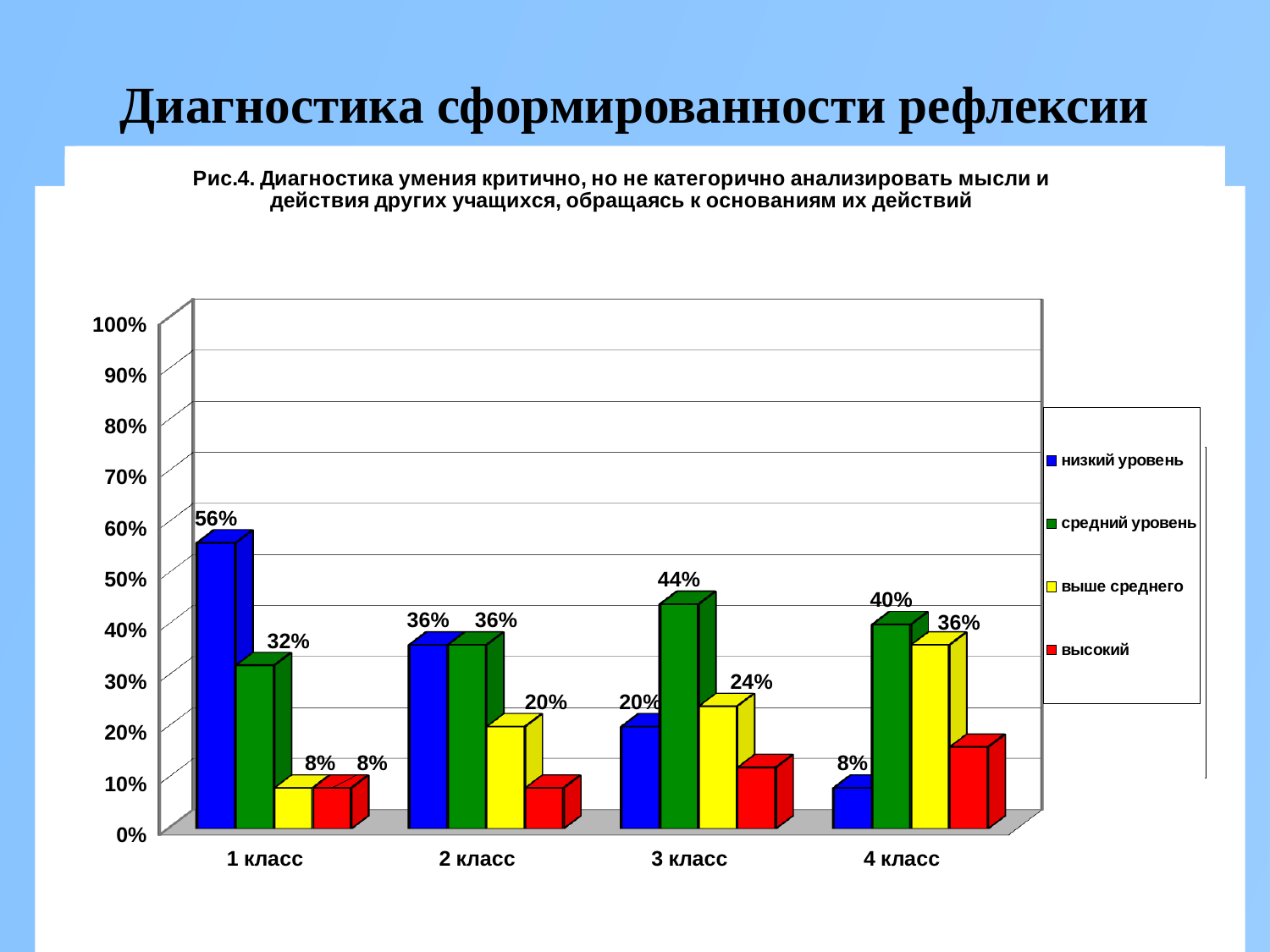
Is the value for высокий in 4 класс greater or less than 20%? less How many classes are shown on the x axis? 4 Which is larger: средний уровень in 4 класс or выше среднего in 4 класс? средний уровень in 4 класс What is the difference between низкий уровень in 1 класс and низкий уровень in 4 класс? 48% What is the value for высокий in 1 класс? 8% How many series does the legend list? 4 What is the value for выше среднего in 4 класс? 36% What is the value for средний уровень in 3 класс? 44% What kind of chart is shown on the slide? bar chart Which class has the highest value for низкий уровень? 1 класс Which class has the lowest value for выше среднего? 1 класс What is the value for низкий уровень in 1 класс? 56%